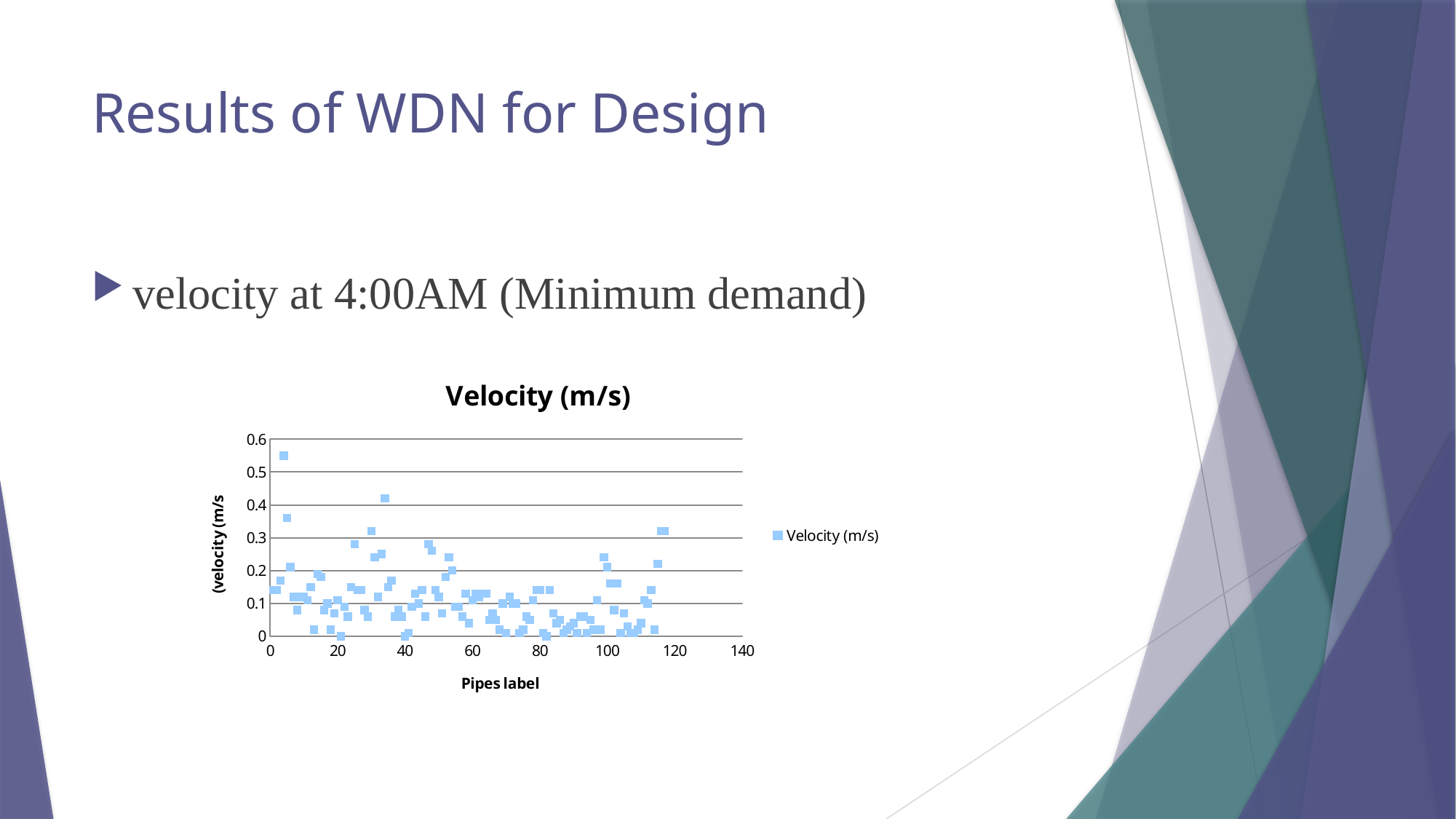
What is the title of the chart? Velocity (m/s) Is the velocity plotted for the pipe near label 35 greater or less than 0.3? greater How many series does the chart legend list? 1 What is the label of the x axis of the chart? Pipes label What kind of chart is shown on the slide? scatter chart What is the maximum value shown on the y axis of the chart? 0.6 Is the velocity plotted for the pipe near label 4 greater or less than 0.4? greater Is the highest plotted velocity value in the chart greater or less than 0.5? greater